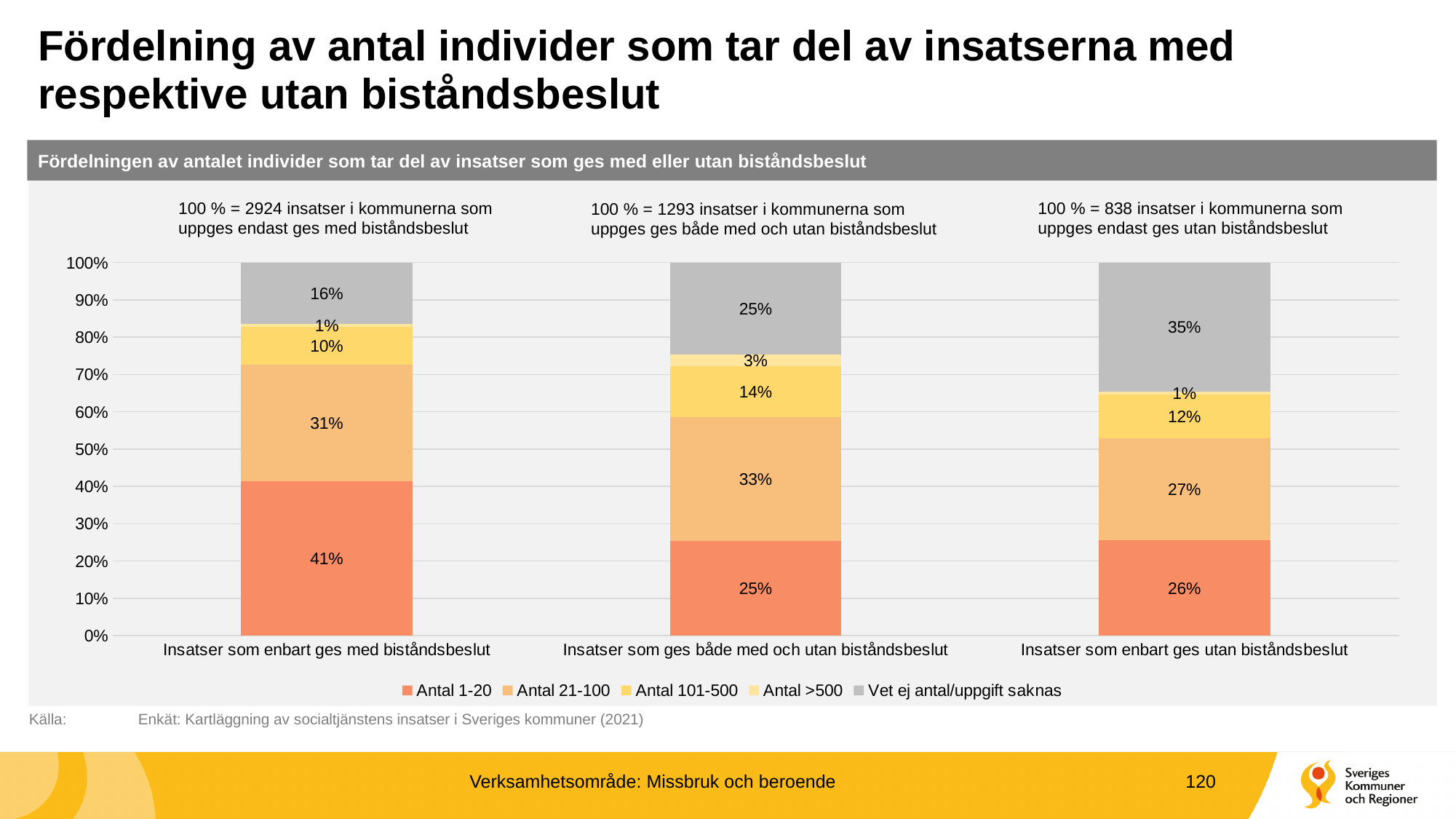
According to the note above the chart, how many insatser does 100 % correspond to for 'Insatser som enbart ges med biståndsbeslut'? 2924 How many categories are shown on the x axis? 3 What kind of chart is shown on the slide? Stacked bar chart What is the value of 'Vet ej antal/uppgift saknas' for 'Insatser som enbart ges utan biståndsbeslut'? 35% How many series does the legend list? 5 What is the value of 'Antal 21-100' for 'Insatser som ges både med och utan biståndsbeslut'? 33% Which category has the lowest value for 'Vet ej antal/uppgift saknas'? Insatser som enbart ges med biståndsbeslut Which is larger: 'Antal 101-500' for 'Insatser som ges både med och utan biståndsbeslut' or for 'Insatser som enbart ges utan biståndsbeslut'? Insatser som ges både med och utan biståndsbeslut What is the value of 'Antal 1-20' for 'Insatser som enbart ges med biståndsbeslut'? 41% Which category has the highest value for 'Antal 1-20'? Insatser som enbart ges med biståndsbeslut What is the value of 'Antal >500' for 'Insatser som ges både med och utan biståndsbeslut'? 3% What is the difference between the 'Antal 1-20' values for 'Insatser som enbart ges med biståndsbeslut' and 'Insatser som ges både med och utan biståndsbeslut'? 16 percentage points